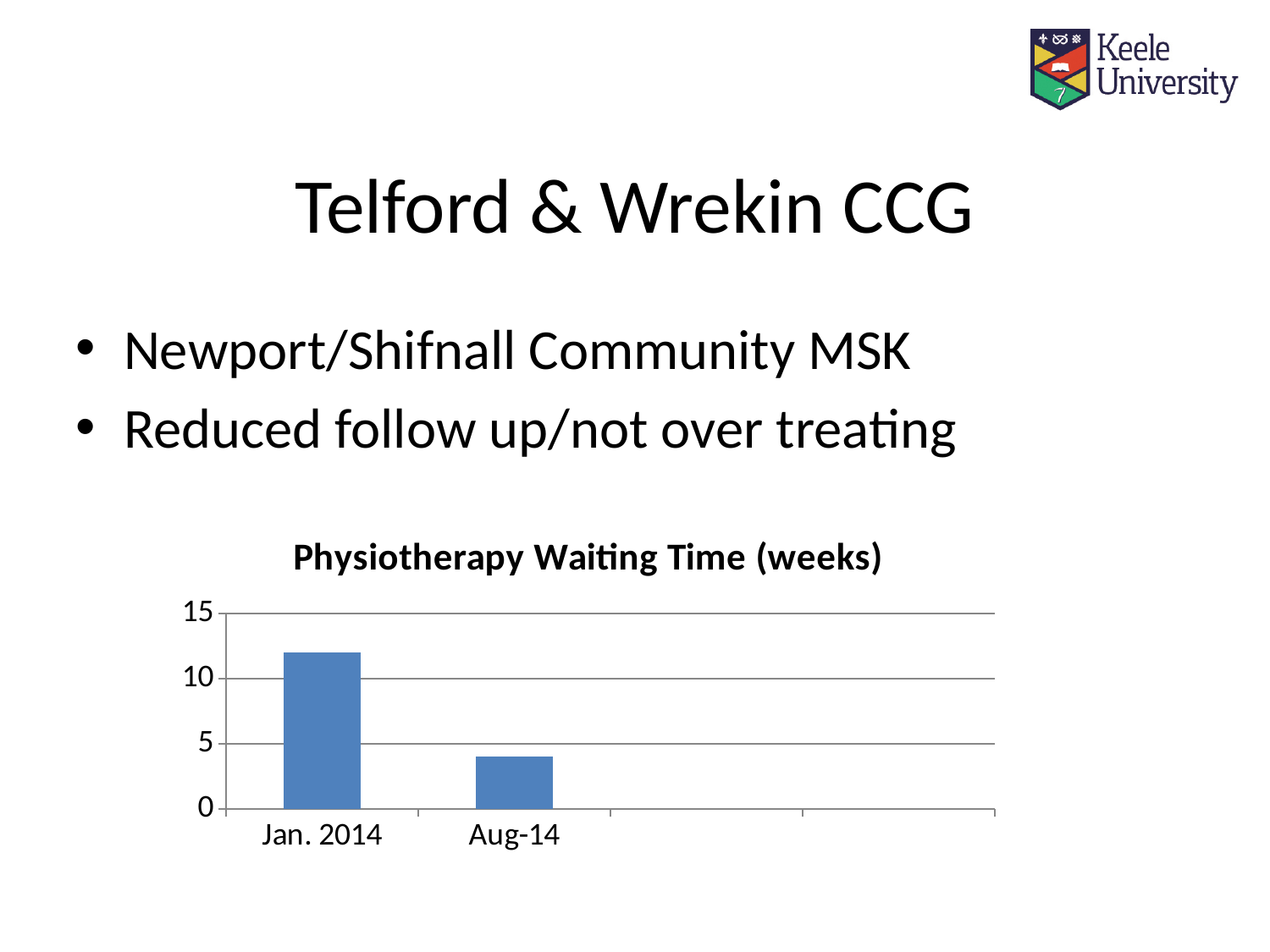
What is the title of the chart? Physiotherapy Waiting Time (weeks) What kind of chart is shown on the slide? bar chart Which category has the highest physiotherapy waiting time? Jan. 2014 Is the value for Jan. 2014 greater or less than 15? less Is the value for Jan. 2014 greater or less than 10? greater Is the value for Aug-14 greater or less than 5? less Do the values rise or fall from Jan. 2014 to Aug-14? fall Which is larger, the waiting time for Jan. 2014 or for Aug-14? Jan. 2014 What is the highest value shown on the vertical axis of the chart? 15 How many categories are plotted in the chart? 2 Which category has the lowest physiotherapy waiting time? Aug-14